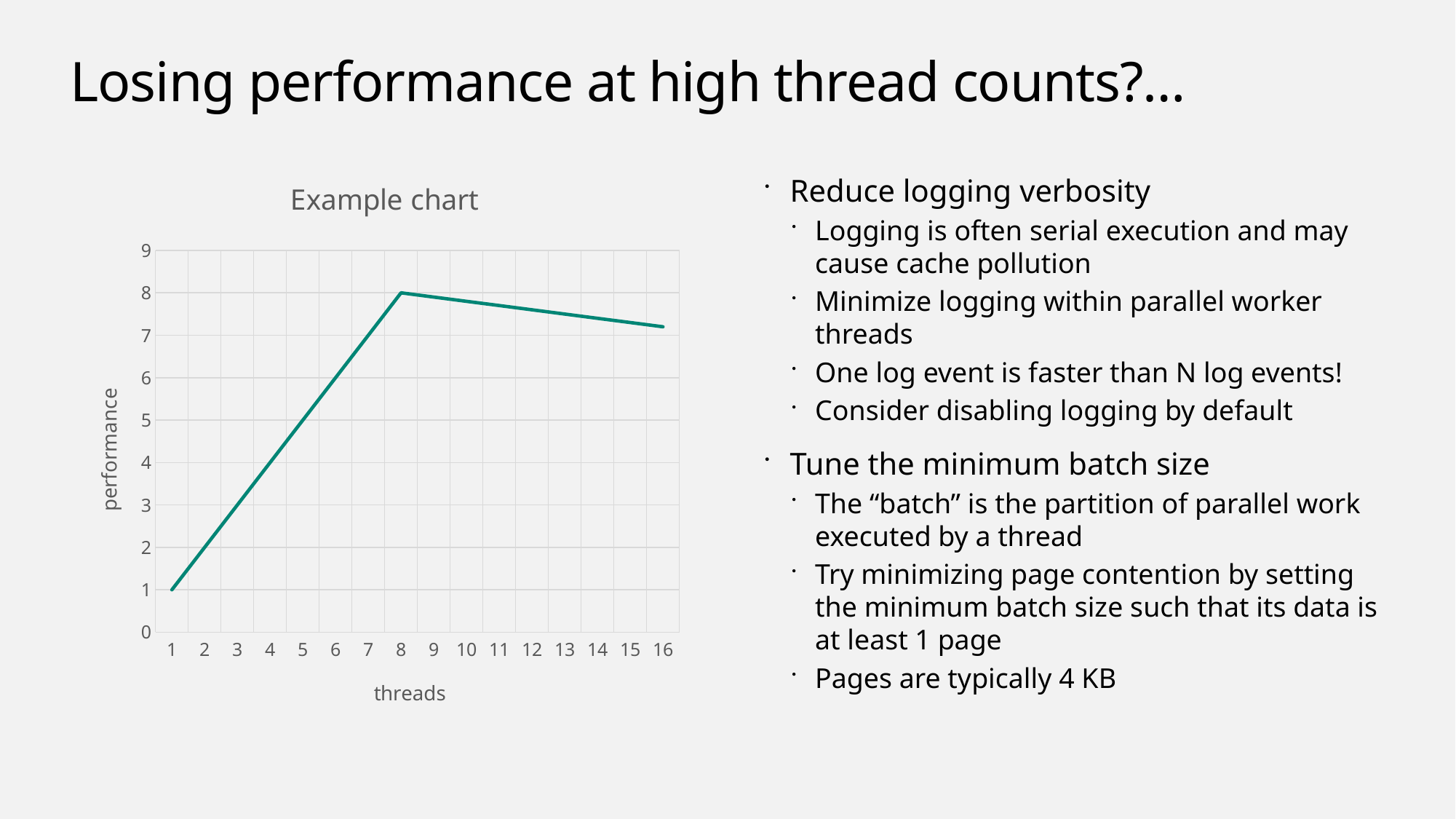
At which thread count does the line reach its highest performance? 8 Does performance rise or fall as threads increase from 8 to 16? fall What is the difference in performance between 8 threads and 1 thread? 7 Is the performance value at 16 threads greater or less than 8? less Which has higher performance, 8 threads or 16 threads? 8 threads What is the label of the x axis of the chart? threads What is the performance value at 8 threads? 8 What is the title of the chart? Example chart What is the performance value at 1 thread? 1 Is the performance value at 16 threads greater or less than 7? greater At which thread count is the performance lowest? 1 What type of chart is shown on the slide? line chart